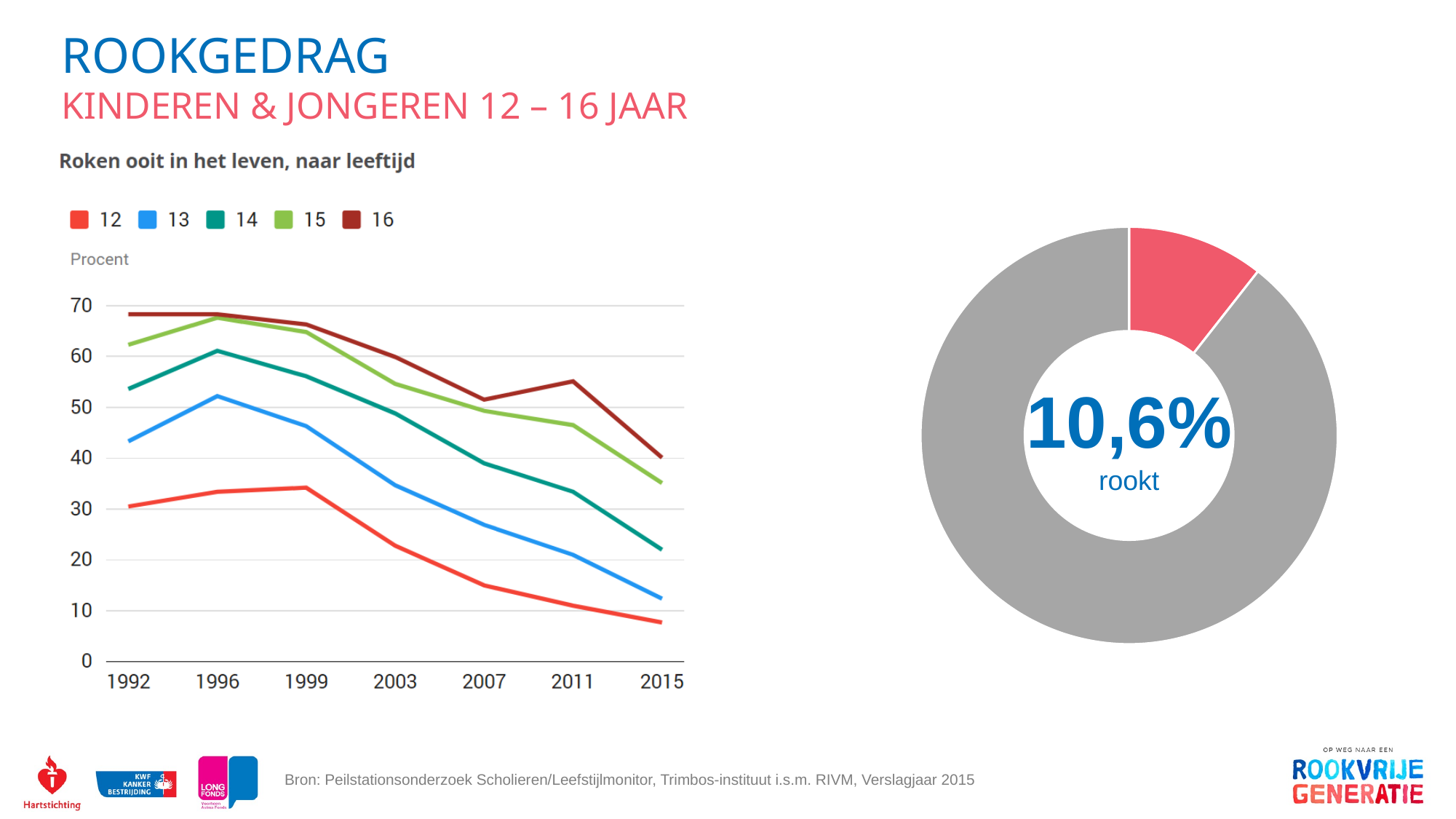
In the line chart 'Roken ooit in het leven, naar leeftijd', is the value for age 12 in 2015 greater or less than 10? less What kind of chart is the chart titled 'Roken ooit in het leven, naar leeftijd'? line chart How many years are shown on the x axis of the line chart 'Roken ooit in het leven, naar leeftijd'? 7 In the line chart 'Roken ooit in het leven, naar leeftijd', do the values for age 12 rise or fall from 1999 to 2015? fall In the line chart 'Roken ooit in het leven, naar leeftijd', is the value for age 15 in 2015 greater or less than 40? less How many series does the legend of the line chart 'Roken ooit in het leven, naar leeftijd' list? 5 In the line chart 'Roken ooit in het leven, naar leeftijd', is the value for age 16 in 1992 greater or less than 60? greater What percentage is shown in the centre of the donut chart on the right of the slide? 10,6% In the line chart 'Roken ooit in het leven, naar leeftijd', which age group has the highest value in 2015? 16 In the line chart 'Roken ooit in het leven, naar leeftijd', which is larger in 2015: the value for age 14 or the value for age 13? 14 In the line chart 'Roken ooit in het leven, naar leeftijd', which age group has the lowest value in 1992? 12 What is the unit label shown above the y axis of the line chart 'Roken ooit in het leven, naar leeftijd'? Procent